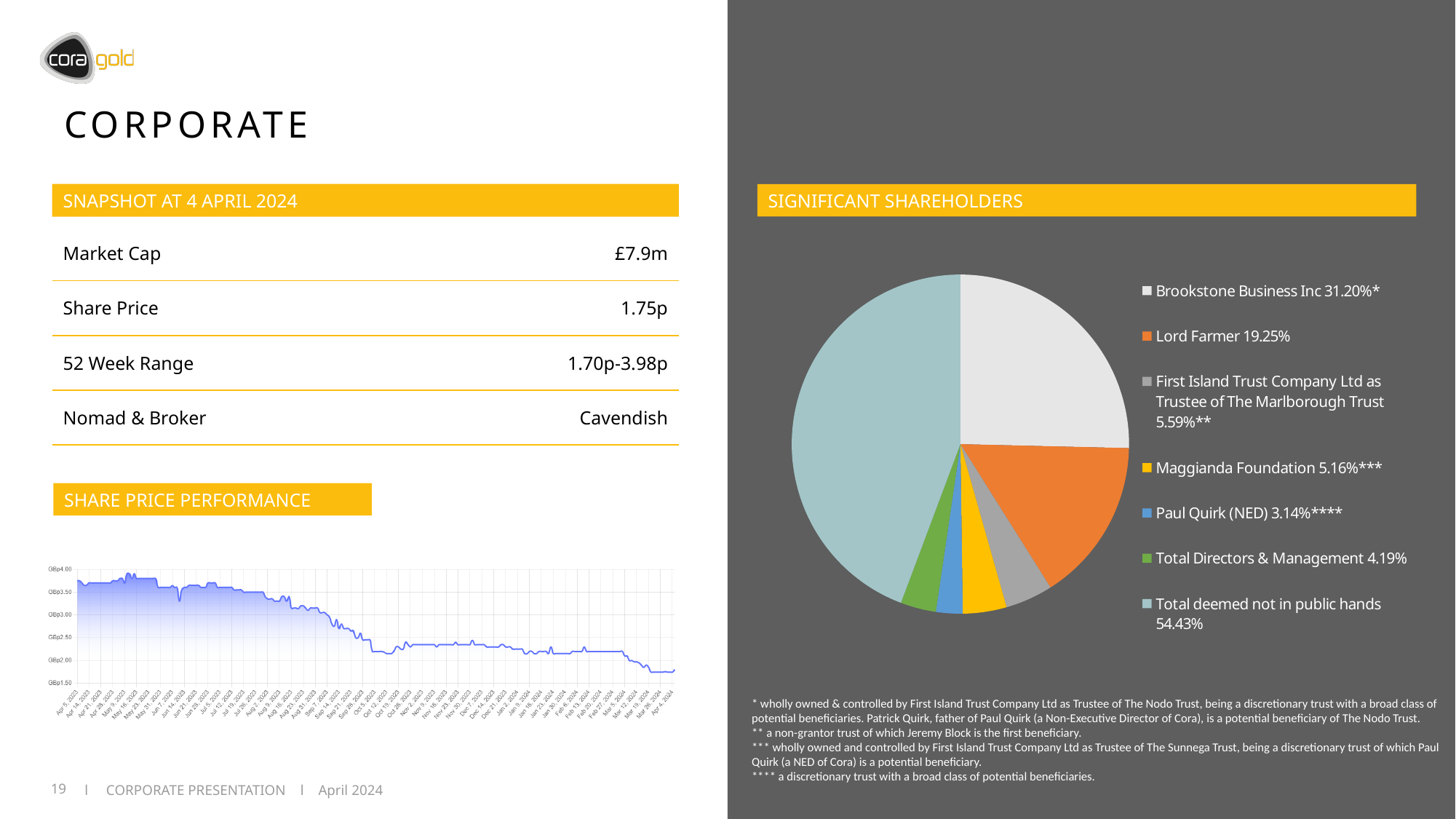
On the Significant Shareholders pie chart, which legend entry has the smallest percentage? Paul Quirk (NED) On the Significant Shareholders pie chart, which legend entry has the largest percentage? Total deemed not in public hands What kind of chart is the Significant Shareholders chart? Pie chart On the Significant Shareholders pie chart, what percentage is shown for Total Directors & Management? 4.19% On the Significant Shareholders pie chart, what percentage is shown for Lord Farmer? 19.25% On the Significant Shareholders pie chart, what percentage is shown for Maggianda Foundation? 5.16% On the Significant Shareholders pie chart, what percentage is shown for Brookstone Business Inc? 31.20% On the Significant Shareholders pie chart, which is larger: Maggianda Foundation or First Island Trust Company Ltd as Trustee of The Marlborough Trust? First Island Trust Company Ltd as Trustee of The Marlborough Trust On the Significant Shareholders pie chart, what is the difference between the Brookstone Business Inc percentage and the Lord Farmer percentage? 11.95% On the Share Price Performance chart, does the share price generally rise or fall from April 2023 to April 2024? Fall What kind of chart is the Share Price Performance chart? Line chart How many entries does the legend of the Significant Shareholders pie chart list? 7